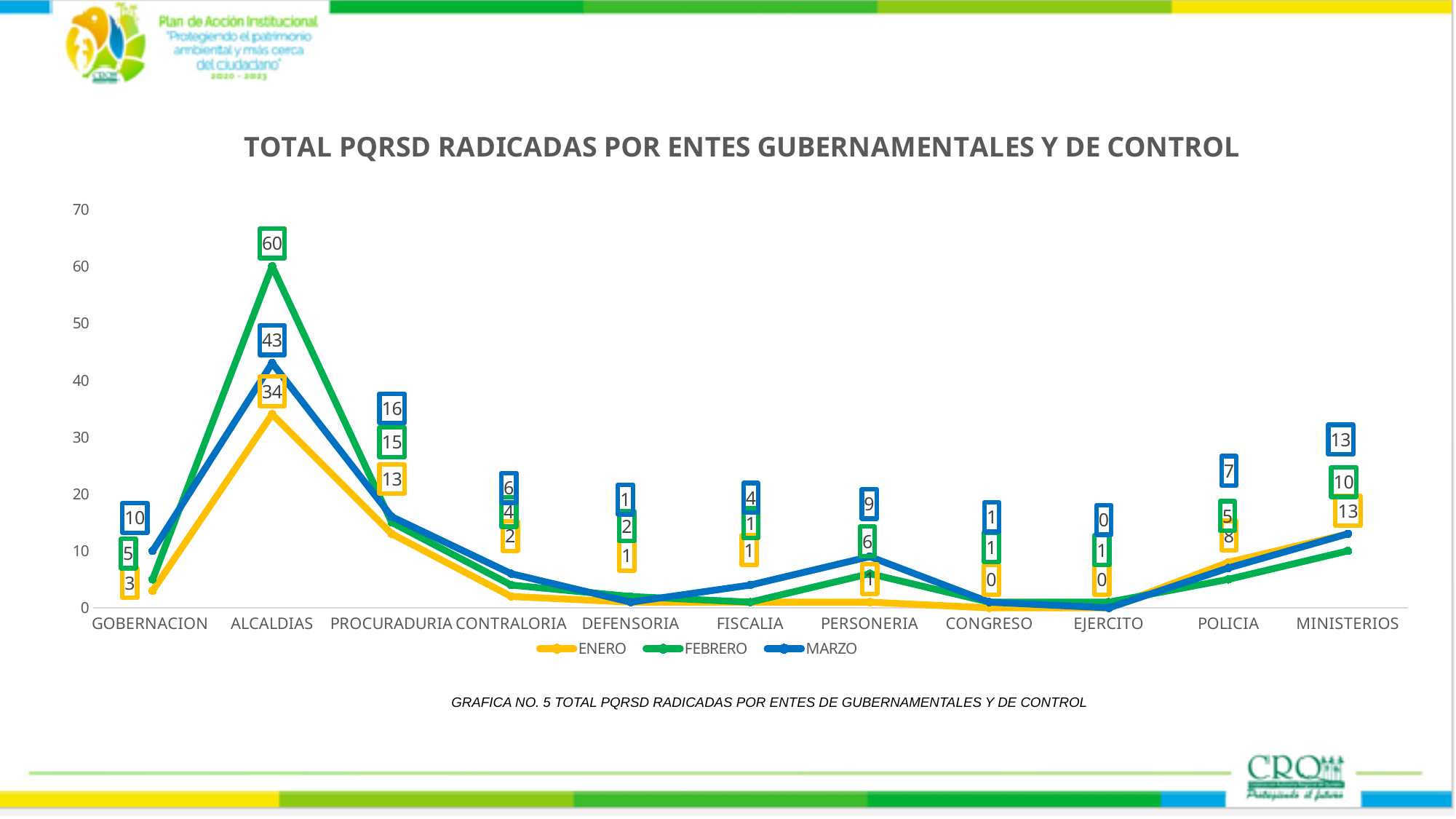
What is the FEBRERO value for ALCALDIAS? 60 What type of chart is shown on the slide? line chart Which is larger for PERSONERIA, the MARZO value or the FEBRERO value? MARZO What is the difference between the FEBRERO and ENERO values for ALCALDIAS? 26 What is the title of the chart? TOTAL PQRSD RADICADAS POR ENTES GUBERNAMENTALES Y DE CONTROL Which category has the highest MARZO value? ALCALDIAS How many categories are shown on the x axis? 11 What is the ENERO value for POLICIA? 8 How many series does the legend list? 3 What is the MARZO value for PROCURADURIA? 16 Which series is drawn in blue? MARZO What is the MARZO value for EJERCITO? 0